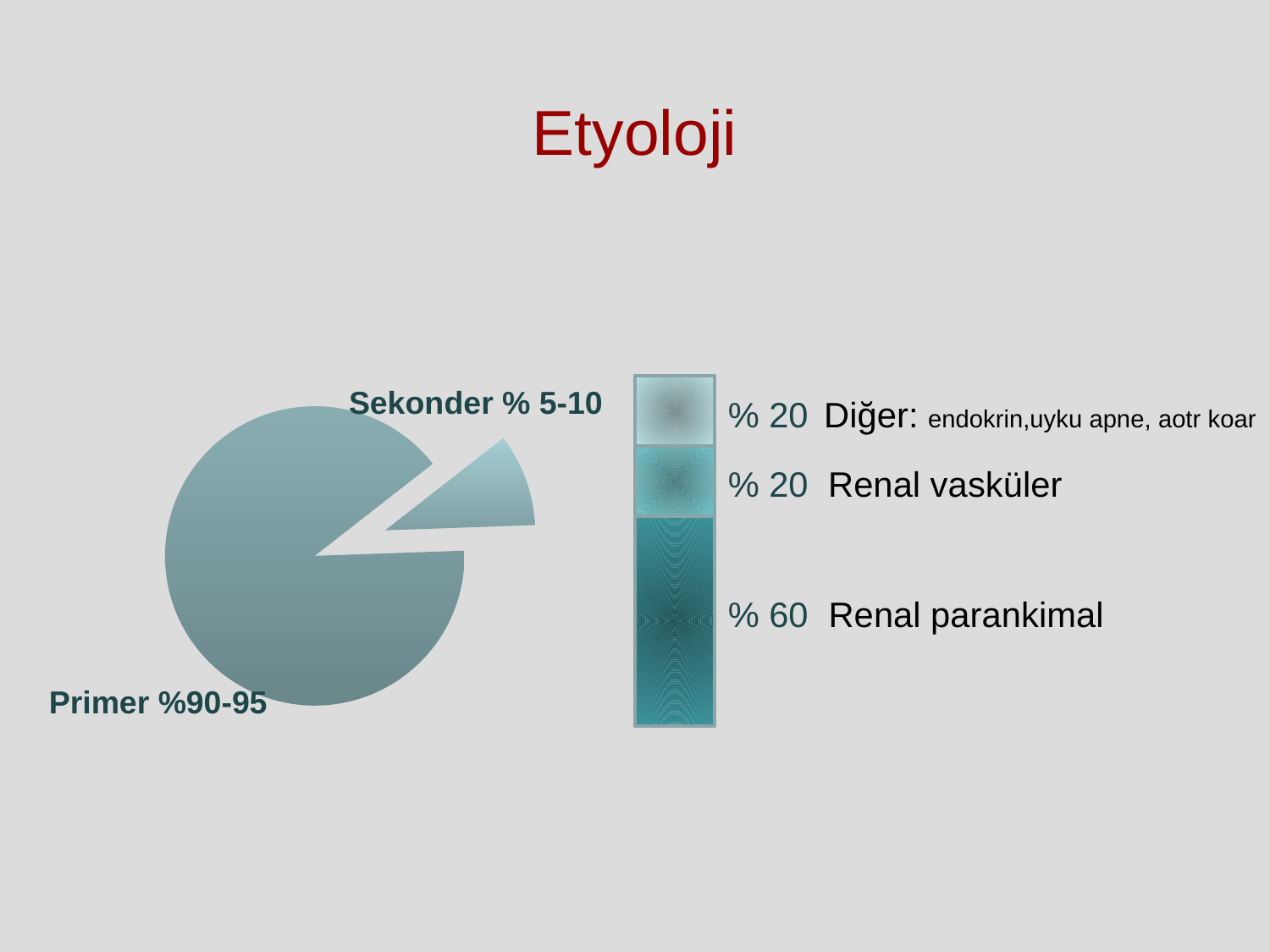
In the stacked bar on the right, what is the value for Renal parankimal? % 60 In the pie chart on the left, what share is labelled for Primer? %90-95 In the stacked bar on the right, what is the value for Renal vasküler? % 20 In the pie chart on the left, what share is labelled for Sekonder? % 5-10 In the pie chart on the left, which slice is the largest? Primer In the stacked bar on the right, which segment is the largest? Renal parankimal In the stacked bar on the right, what is the difference between Renal parankimal and Renal vasküler? % 40 How many slices does the pie chart on the left have? 2 In the pie chart on the left, which slice is the smallest? Sekonder In the stacked bar on the right, what is the value for Diğer? % 20 What kind of chart is on the left side of the slide? pie chart How many segments does the stacked bar on the right have? 3